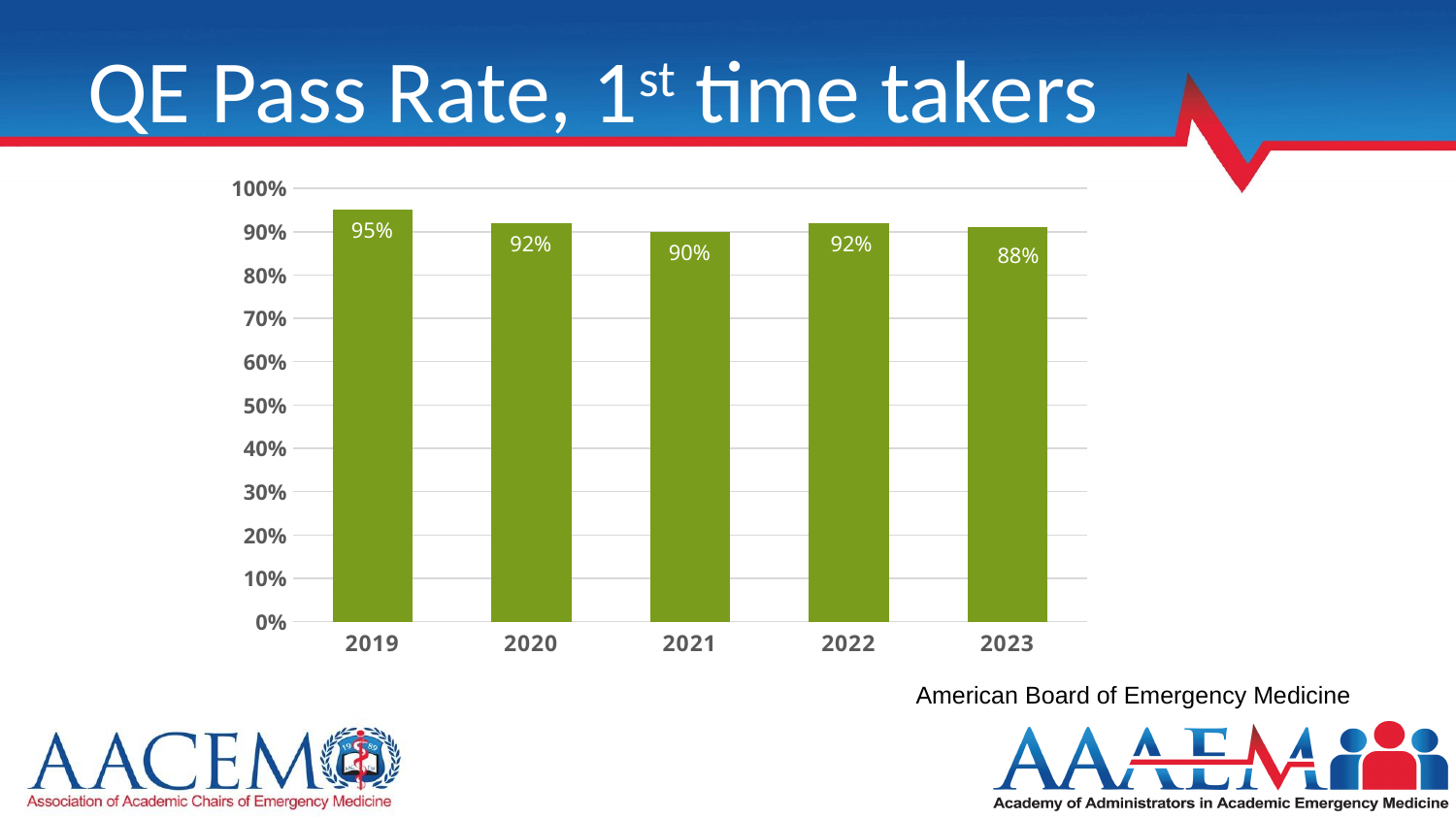
What kind of chart is shown on the slide? bar chart Does the pass rate generally rise or fall from 2019 to 2023? fall Which year had a higher pass rate, 2021 or 2022? 2022 What is the difference between the pass rate in 2019 and the pass rate in 2023? 7% What is the title of the slide? QE Pass Rate, 1st time takers What was the QE pass rate for 1st time takers in 2023? 88% Which year had the highest QE pass rate for 1st time takers? 2019 What was the QE pass rate for 1st time takers in 2019? 95% Which year had the lowest QE pass rate for 1st time takers? 2023 How many years are shown on the chart? 5 What was the QE pass rate for 1st time takers in 2021? 90%